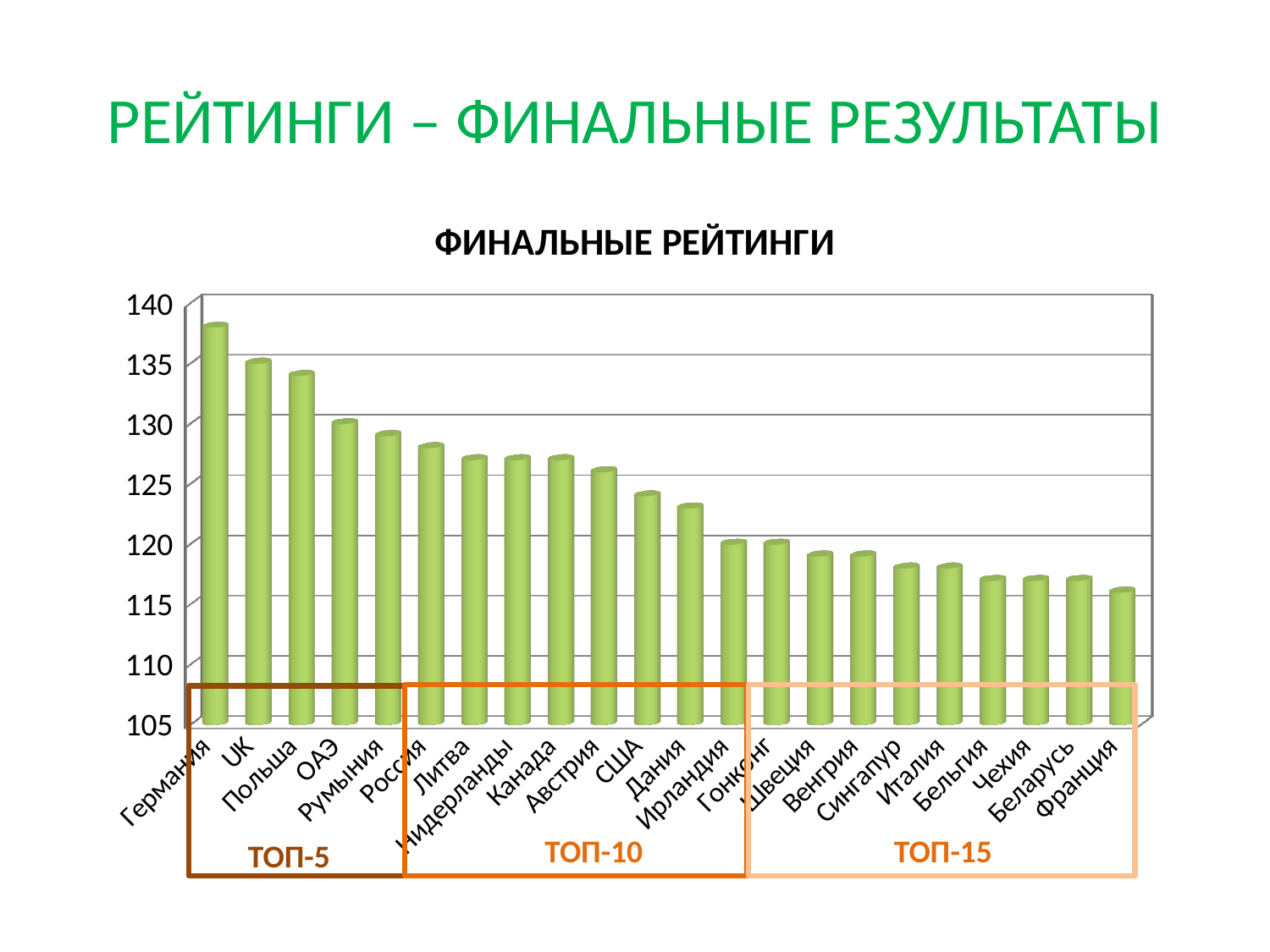
Is the value for Россия greater or less than 125? greater How many countries are shown on the chart? 22 Is the value for Ирландия greater or less than 125? less Which country has the highest rating on the chart? Германия What is the title of the chart? ФИНАЛЬНЫЕ РЕЙТИНГИ Which has a higher value, Польша or Канада? Польша Which country has the lowest rating on the chart? Франция Is the value for Германия greater or less than 135? greater What are the three group labels shown in the boxes below the chart? ТОП-5, ТОП-10, ТОП-15 What kind of chart is shown on the slide? bar chart Do the values rise or fall from left to right along the x axis? fall